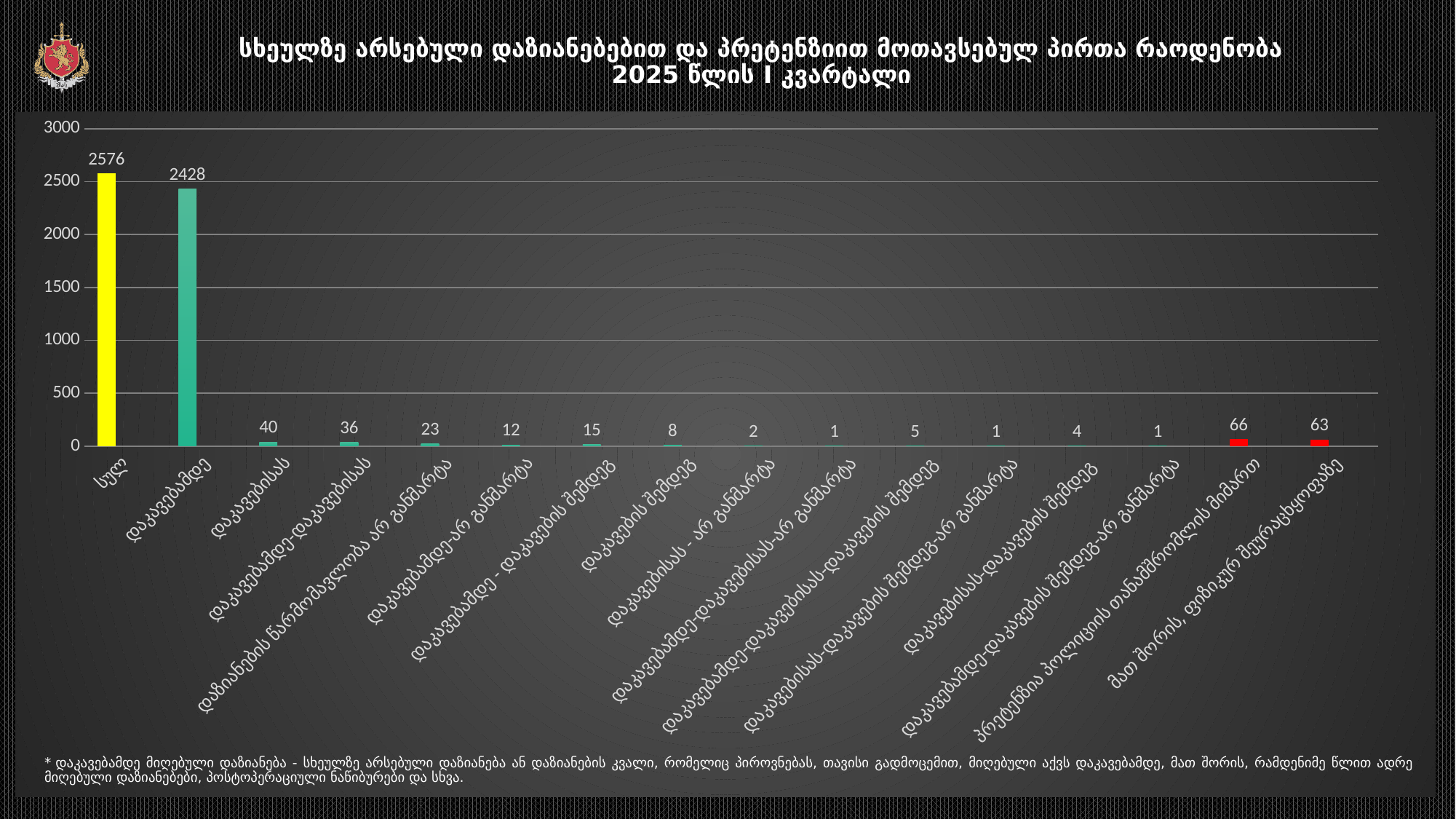
What is the difference between the values for სულ and დაკავებამდე? 148 What kind of chart is shown on the slide? Bar chart How many categories are shown on the x axis? 16 What is the value for სულ? 2576 What is the difference between the values for პრეტენზია პოლიციის თანამშრომლის მიმართ and მათ შორის, ფიზიკურ შეურაცხყოფაზე? 3 What is the value for მათ შორის, ფიზიკურ შეურაცხყოფაზე? 63 What is the value for პრეტენზია პოლიციის თანამშრომლის მიმართ? 66 Which category has the highest value? სულ What is the value for დაკავებამდე? 2428 What colour is the bar for სულ? Yellow What is the value for დაკავებისას? 40 Which is larger, the value for დაკავებისას or the value for დაკავებამდე-დაკავებისას? დაკავებისას